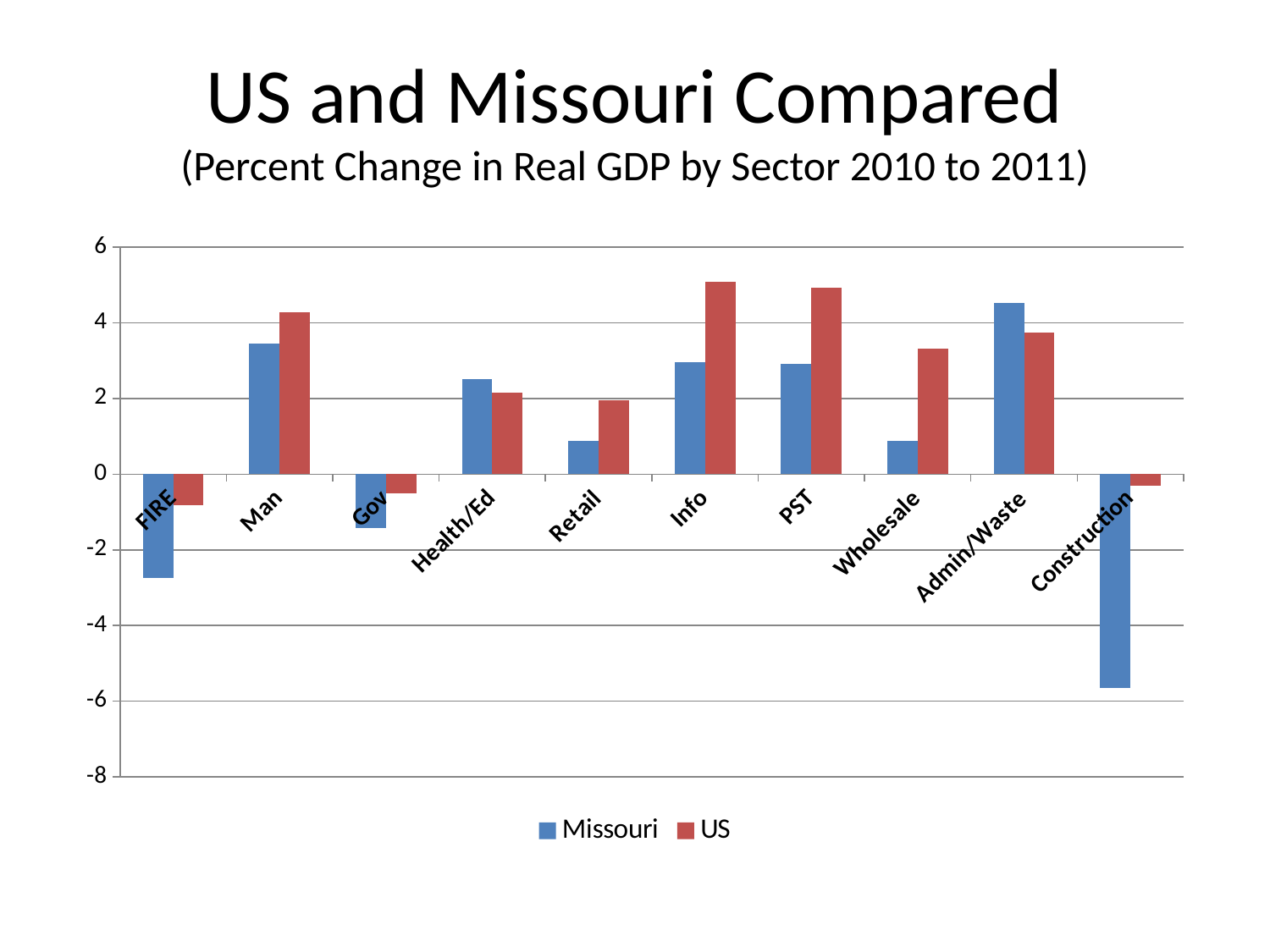
Which sector has the lowest Missouri value? Construction What kind of chart is shown on the slide? bar chart How many series does the legend list? 2 Which sector has the highest Missouri value? Admin/Waste Is the Missouri value for Construction greater or less than -4? less Which sector has the lowest US value? FIRE Is the Missouri value for FIRE greater or less than -2? less How many sectors are shown on the x axis? 10 For Admin/Waste, which is larger, the Missouri value or the US value? Missouri Is the US value for Wholesale greater or less than 2? greater For Man, which is larger, the Missouri value or the US value? US